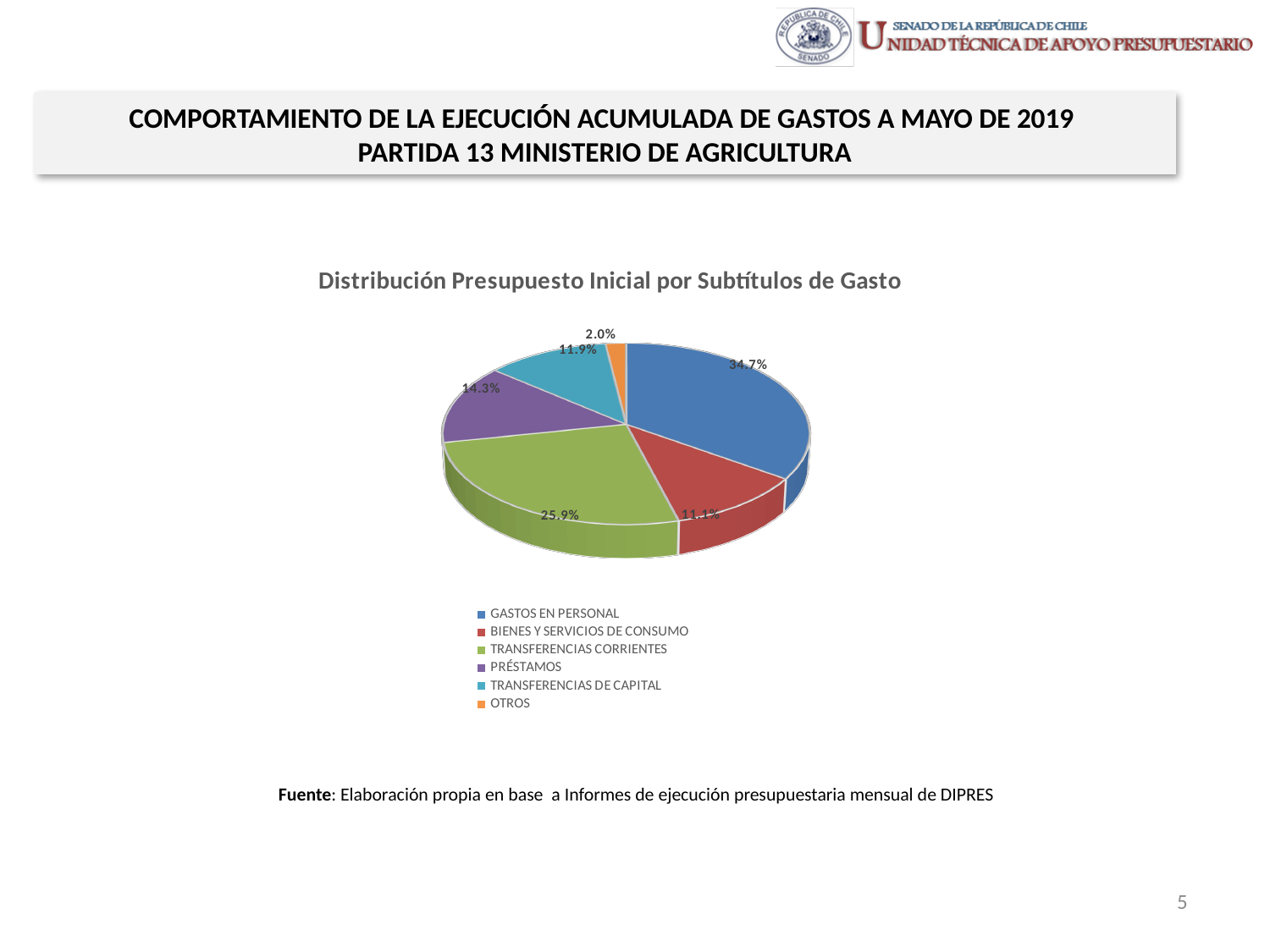
What is the title of the chart? Distribución Presupuesto Inicial por Subtítulos de Gasto What share of the pie is GASTOS EN PERSONAL? 34.7% What share of the pie is TRANSFERENCIAS CORRIENTES? 25.9% What share of the pie is BIENES Y SERVICIOS DE CONSUMO? 11.1% Which category has the largest share of the pie? GASTOS EN PERSONAL Which category has the smallest share of the pie? OTROS How many categories does the legend list? 6 What kind of chart is shown on the slide? Pie chart Which is larger, the share for PRÉSTAMOS or the share for TRANSFERENCIAS DE CAPITAL? PRÉSTAMOS What is the difference in percentage points between GASTOS EN PERSONAL and TRANSFERENCIAS CORRIENTES? 8.8